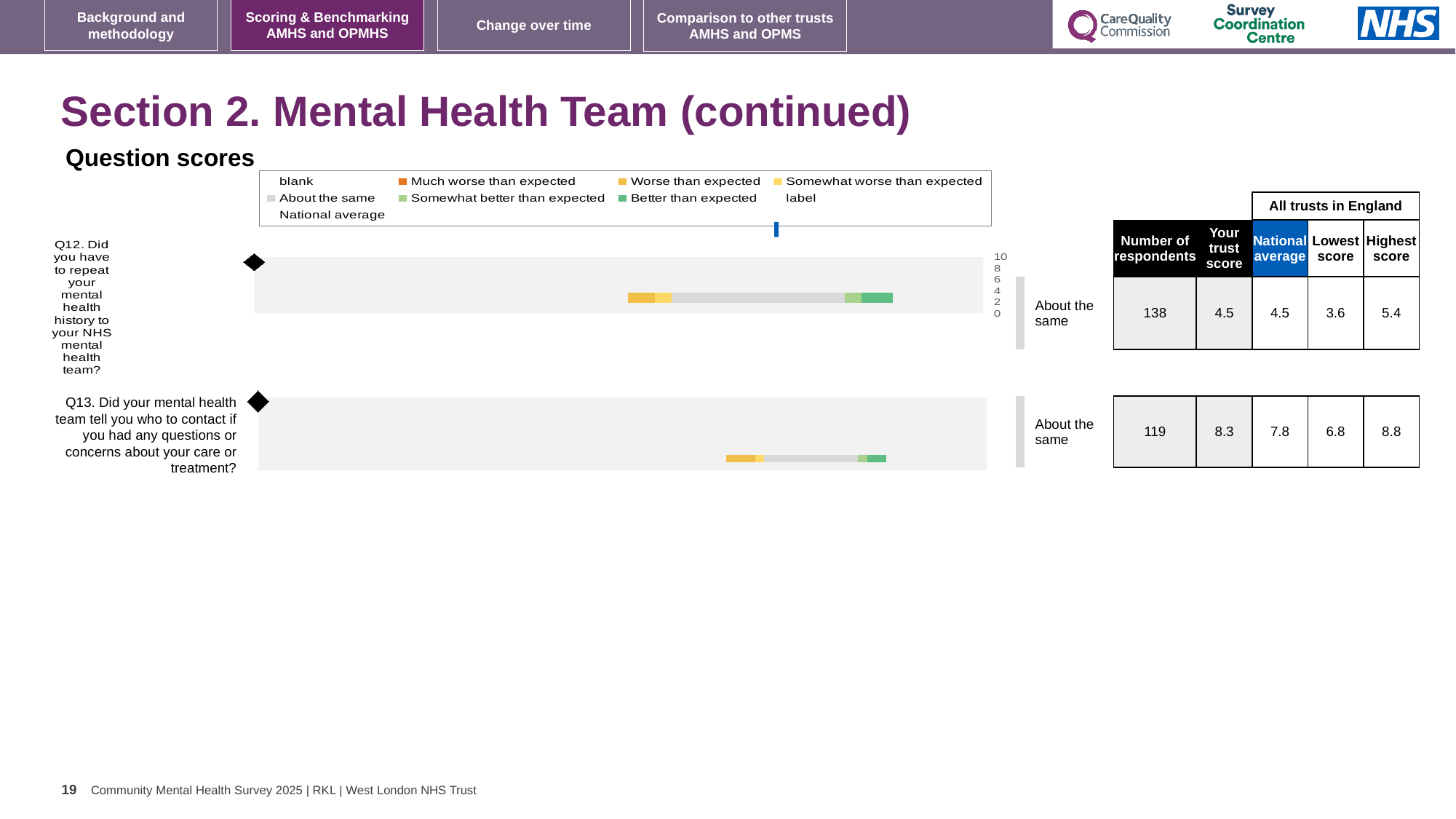
In the table beside the chart, how many respondents answered Q13? 119 For Q13, which is larger: the trust score or the national average? trust score In the table beside the chart, what is the lowest score across all trusts in England for Q12? 3.6 In the table beside the chart, what is the trust score for Q12? 4.5 How many more respondents answered Q12 than Q13? 19 In the table beside the chart, what is the national average for Q13? 7.8 Which colour in the legend represents 'Better than expected'? green What is the difference between the highest score and the lowest score for Q13? 2.0 What kind of chart is used to show the question scores for Q12 and Q13? bar chart What benchmark category label is shown to the right of the Q12 bar? About the same How many questions are plotted on the slide? 2 Which question has the higher trust score, Q12 or Q13? Q13